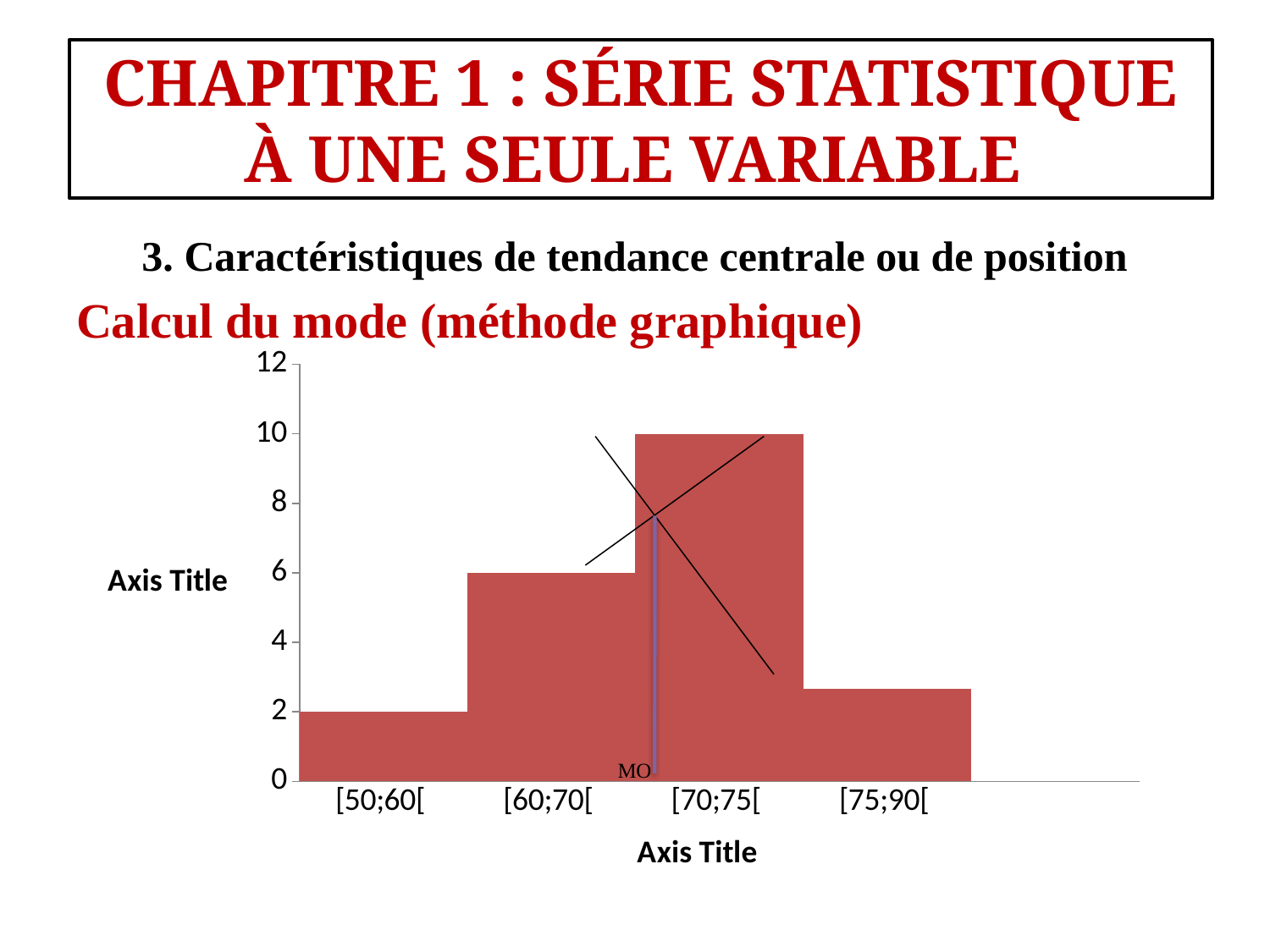
Is the value for [75;90[ greater or less than 4? less What label is written at the base of the vertical line inside the [70;75[ bar? MO Is the value for [75;90[ greater or less than 2? greater What kind of chart is shown on the slide? bar chart Which class has the highest value? [70;75[ What is the value for the [70;75[ class? 10 Do the values rise or fall from [50;60[ to [70;75[? rise What is the value for the [60;70[ class? 6 What is the value for the [50;60[ class? 2 How many classes are shown on the x axis? 4 What is the difference between the values for [70;75[ and [60;70[? 4 Which is larger, the value for [60;70[ or the value for [75;90[? [60;70[